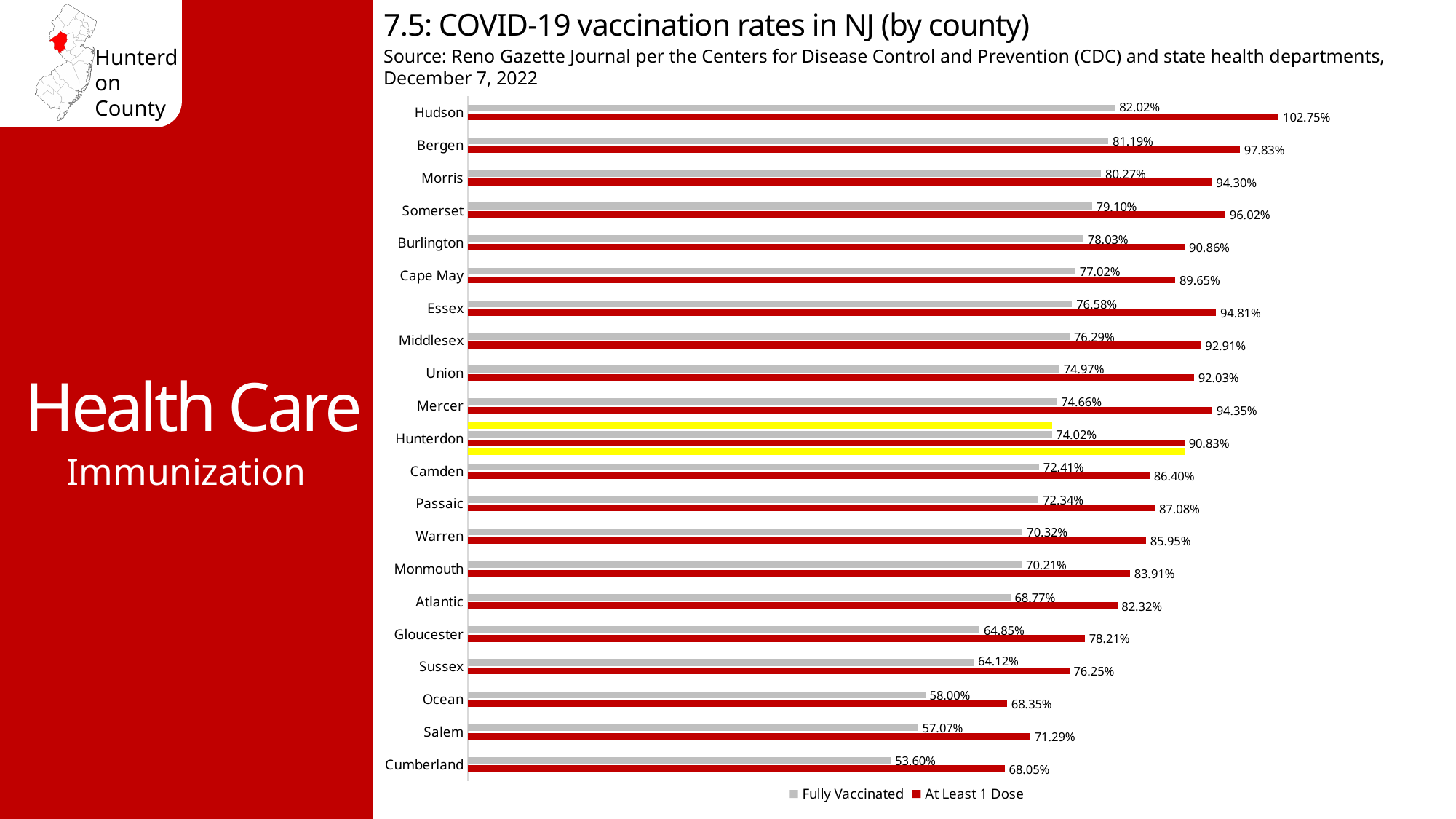
Which county has the higher At Least 1 Dose rate, Mercer or Union? Mercer Which county has the lowest Fully Vaccinated rate? Cumberland What is the difference between the At Least 1 Dose rate and the Fully Vaccinated rate for Hunterdon County? 16.81% How many counties are shown in the chart? 21 What is the Fully Vaccinated rate for Hunterdon County? 74.02% Which county's bars are highlighted in yellow on the chart? Hunterdon Which county has the highest Fully Vaccinated rate? Hudson What kind of chart is shown on the slide? Bar chart What is the At Least 1 Dose rate for Hudson County? 102.75% Which county has the higher Fully Vaccinated rate, Ocean or Salem? Ocean How many series does the legend list? 2 What is the At Least 1 Dose rate for Cumberland County? 68.05%